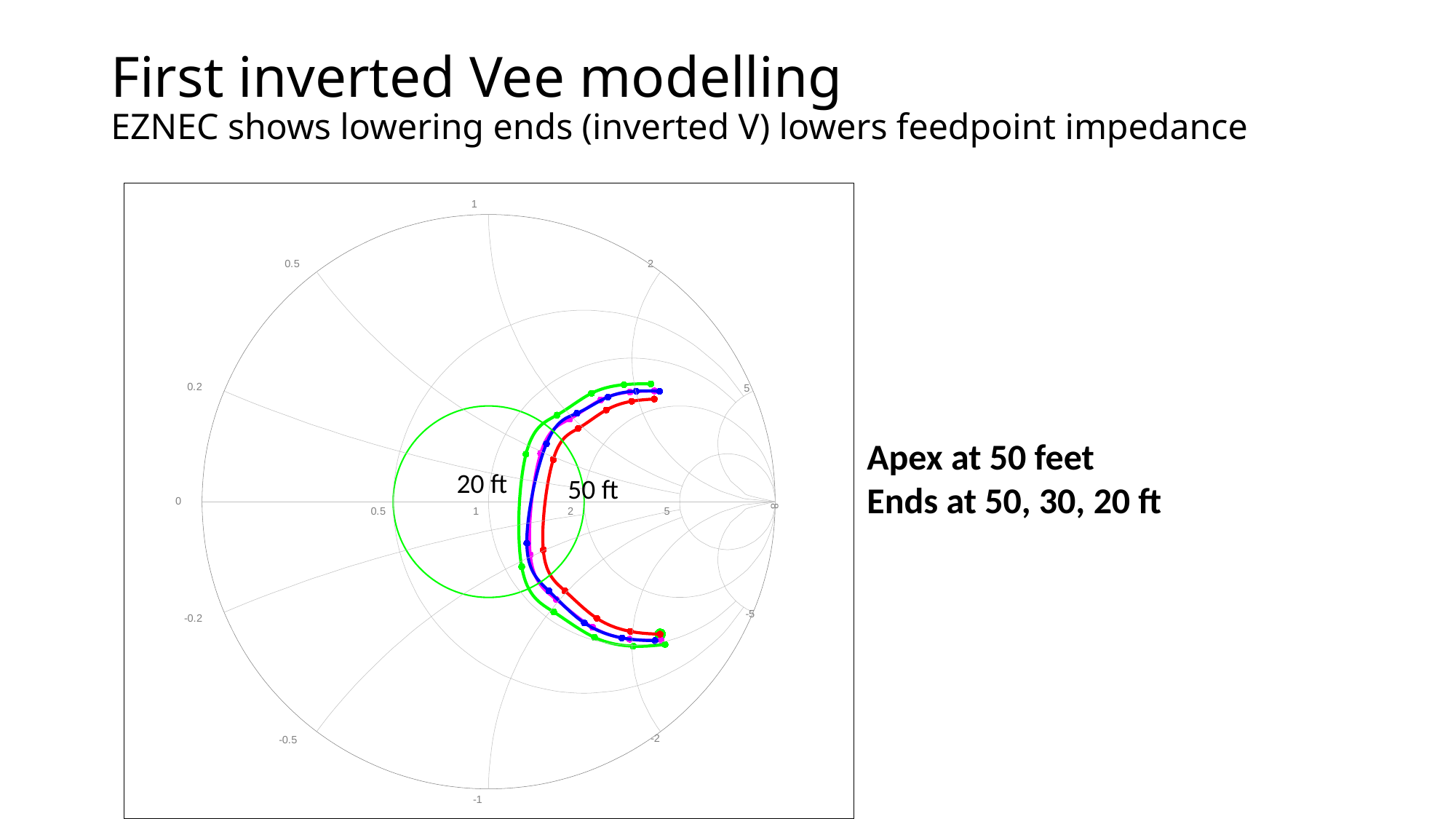
According to the text beside the chart, at what heights are the ends of the antenna modelled? 50, 30, 20 ft Which trace, the one labelled 20 ft or the one labelled 50 ft, lies closer to the centre of the Smith chart? 20 ft What colour is the trace labelled "50 ft" on the chart? Red What kind of chart is shown on the slide? Smith chart What colour is the trace labelled "20 ft" on the chart? Green According to the text beside the chart, at what height is the apex of the inverted Vee? 50 feet What is the title of the slide containing the chart? First inverted Vee modelling